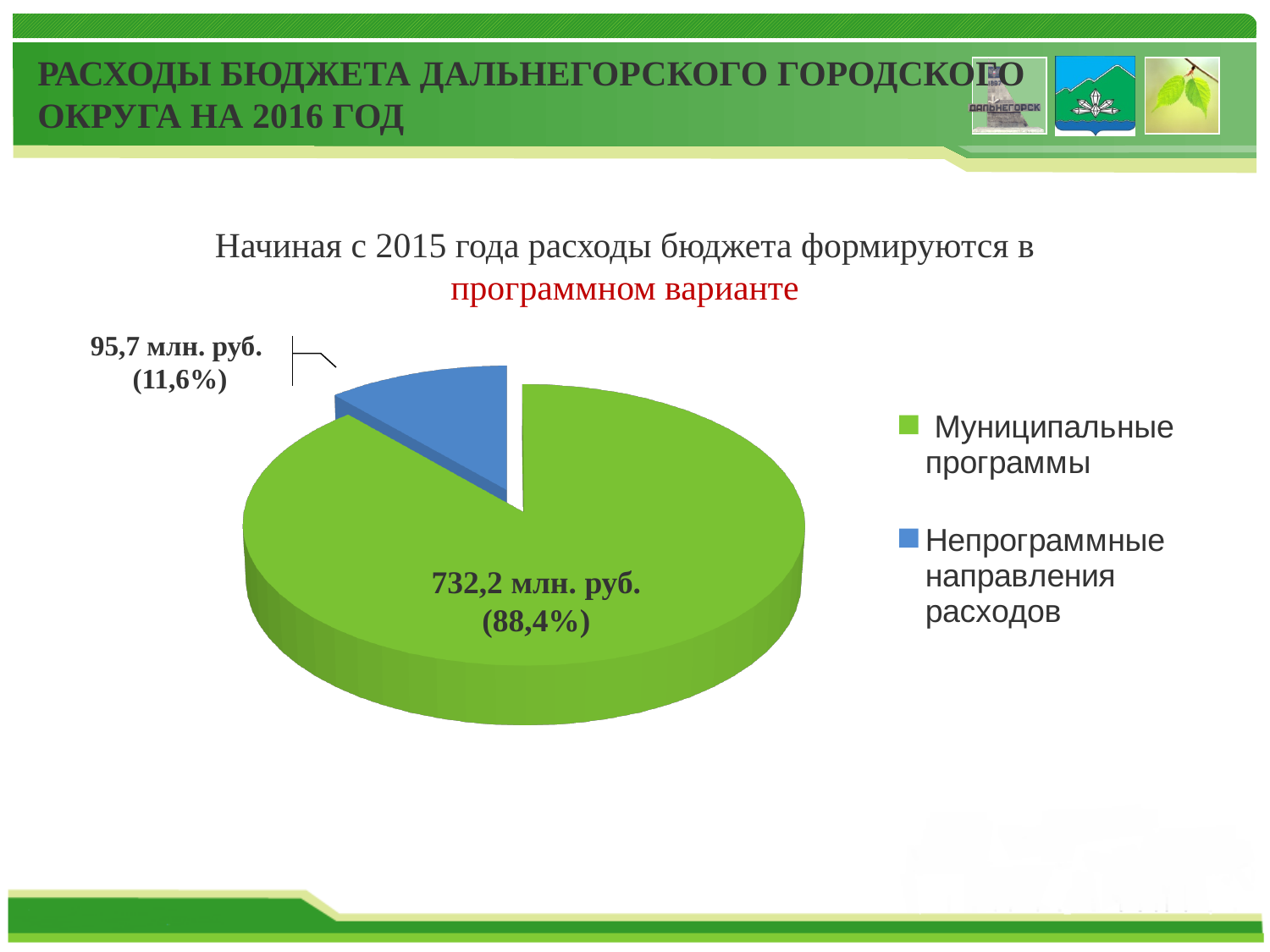
Which is larger: Муниципальные программы or Непрограммные направления расходов? Муниципальные программы What share of the pie does Непрограммные направления расходов take? 11,6% What colour is the slice for Непрограммные направления расходов? blue What share of the pie does Муниципальные программы take? 88,4% How many slices does the pie chart have? 2 Which category has the largest slice of the pie? Муниципальные программы What kind of chart is shown on the slide? pie chart What is the difference in млн. руб. between Муниципальные программы and Непрограммные направления расходов? 636,5 млн. руб. What is the value for Непрограммные направления расходов? 95,7 млн. руб. Which category has the smallest slice of the pie? Непрограммные направления расходов How many entries does the legend list? 2 What is the value for Муниципальные программы? 732,2 млн. руб.